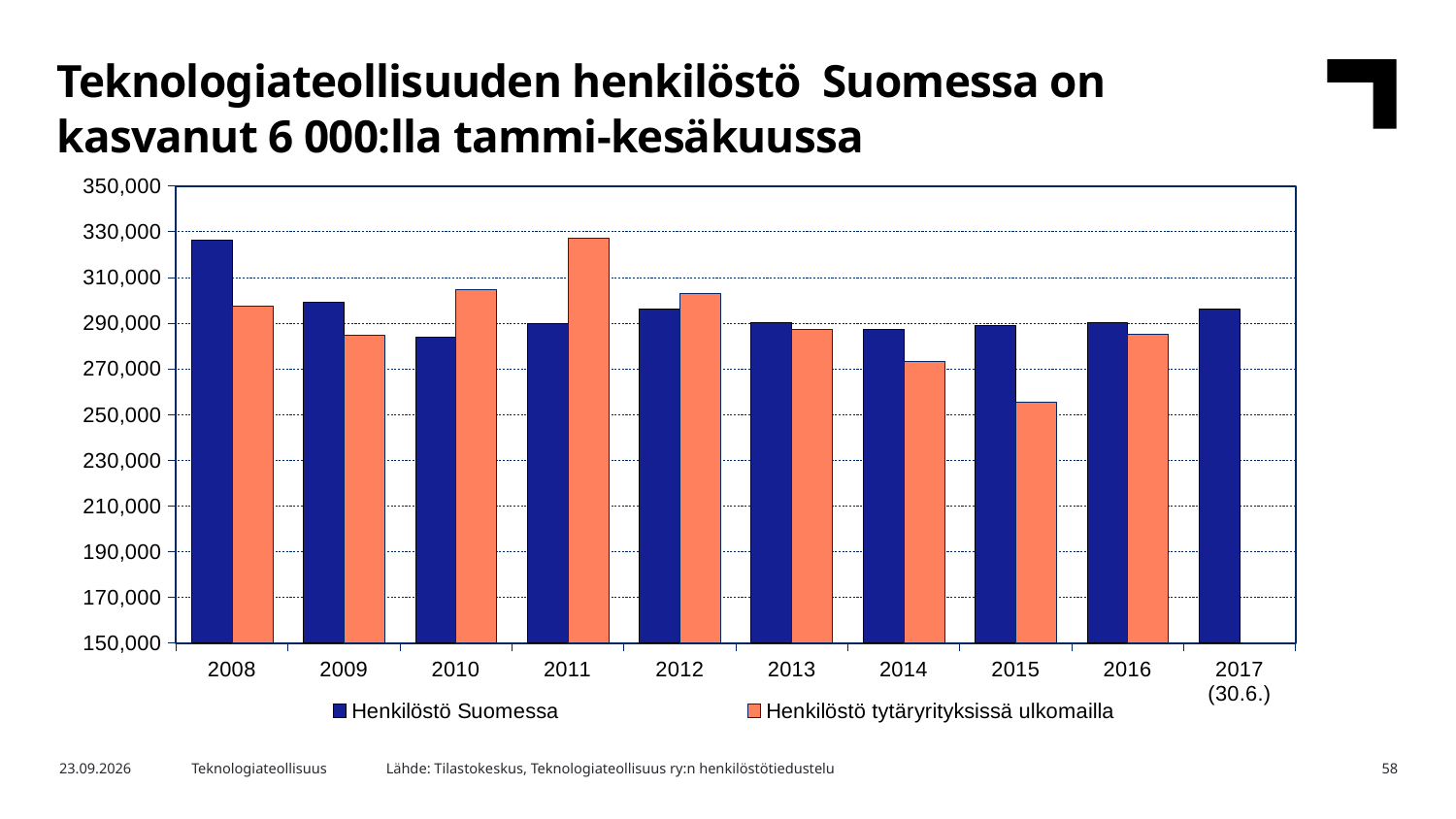
Is the value for Henkilöstö tytäryrityksissä ulkomailla in 2014 greater or less than 290,000? less What kind of chart is shown on the slide? bar chart Does the value for Henkilöstö tytäryrityksissä ulkomailla rise or fall from 2011 to 2015? fall In 2015, which series has the larger value: Henkilöstö Suomessa or Henkilöstö tytäryrityksissä ulkomailla? Henkilöstö Suomessa How many series does the legend list? 2 In which year is the value for Henkilöstö tytäryrityksissä ulkomailla highest? 2011 Is the value for Henkilöstö tytäryrityksissä ulkomailla in 2015 greater or less than 270,000? less Is the value for Henkilöstö Suomessa in 2008 greater or less than 310,000? greater In 2011, which series has the larger value: Henkilöstö Suomessa or Henkilöstö tytäryrityksissä ulkomailla? Henkilöstö tytäryrityksissä ulkomailla In which year is the value for Henkilöstö tytäryrityksissä ulkomailla lowest? 2015 How many year categories are shown on the x axis? 10 In which year is the value for Henkilöstö Suomessa highest? 2008